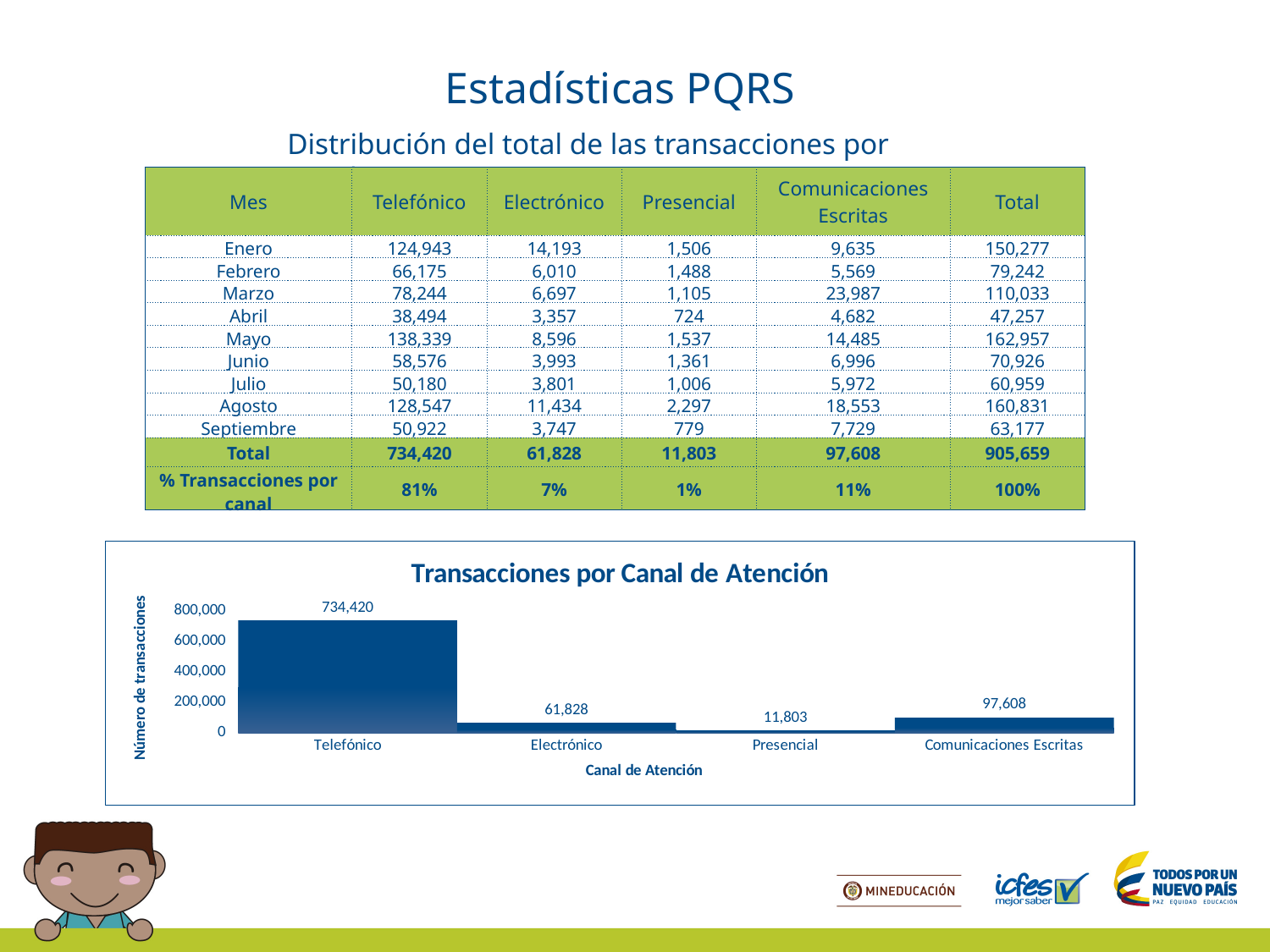
How many channels (categories) are shown in the Transacciones por Canal de Atención chart? 4 Is the value for Telefónico in the chart greater or less than 600,000? greater Which channel has the highest number of transactions in the chart? Telefónico What is the value for Electrónico in the Transacciones por Canal de Atención chart? 61,828 What kind of chart is Transacciones por Canal de Atención? Bar chart Which channel has the lowest number of transactions in the chart? Presencial What is the value for Presencial in the Transacciones por Canal de Atención chart? 11,803 What is the difference between the Telefónico and Electrónico values in the chart? 672,592 Which is larger in the chart, Electrónico or Comunicaciones Escritas? Comunicaciones Escritas What is the value for Comunicaciones Escritas in the Transacciones por Canal de Atención chart? 97,608 What is the value for Telefónico in the Transacciones por Canal de Atención chart? 734,420 What is the difference between the Comunicaciones Escritas and Presencial values in the chart? 85,805